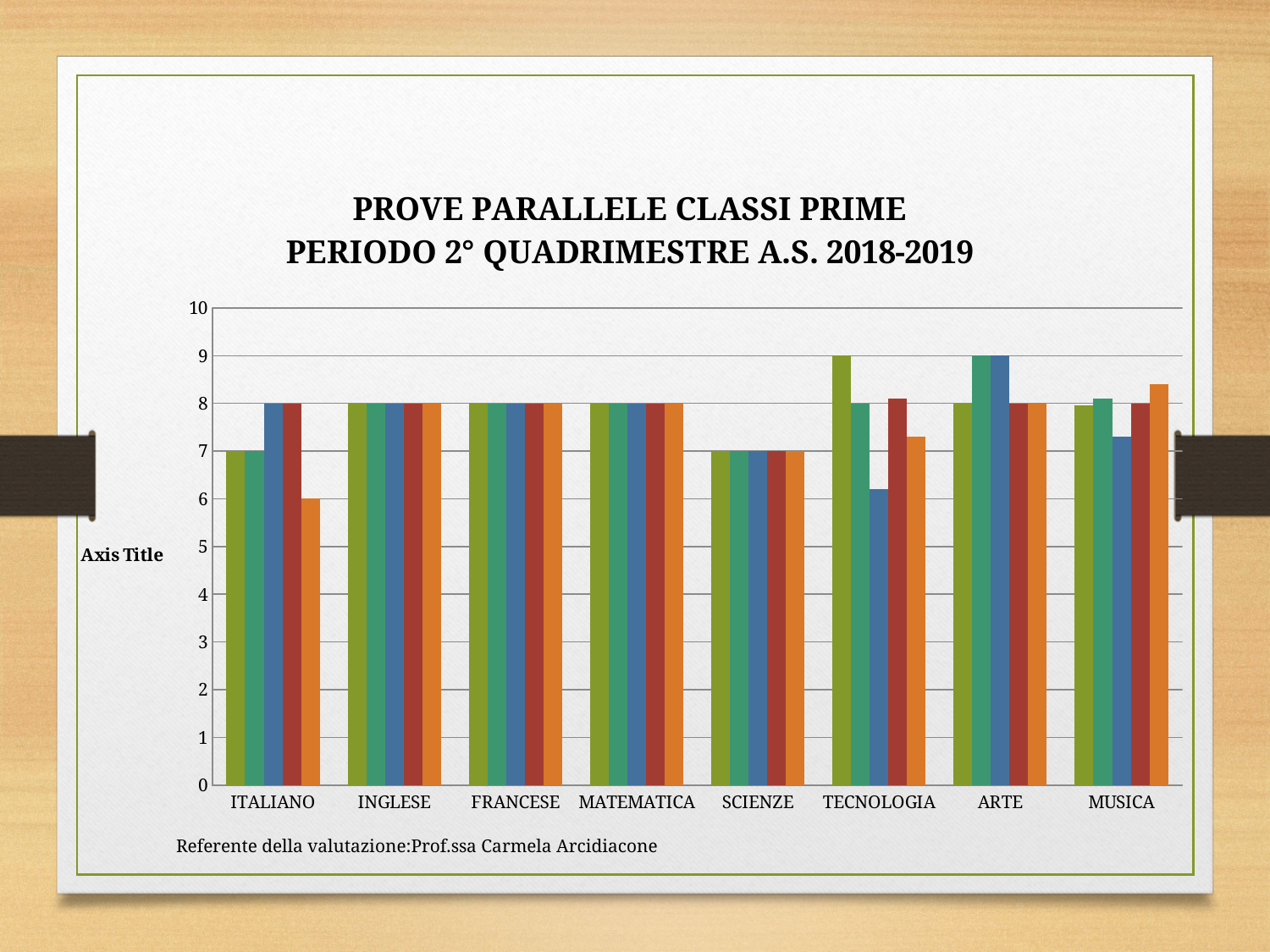
Which category has higher bars, INGLESE or SCIENZE? INGLESE What value do all the bars for FRANCESE reach? 8 What value do all the bars for MATEMATICA reach? 8 Are all the bars for ARTE greater or less than 7? greater What value do all the bars for SCIENZE reach? 7 What is the title of the chart? PROVE PARALLELE CLASSI PRIME PERIODO 2° QUADRIMESTRE A.S. 2018-2019 What value do all the bars for INGLESE reach? 8 How many bars are shown for each category on the x axis? 5 How many categories are shown on the x axis of the chart? 8 What is the difference between the value of the bars for INGLESE and the value of the bars for SCIENZE? 1 What is the label on the vertical axis of the chart? Axis Title What kind of chart is shown on the slide? bar chart